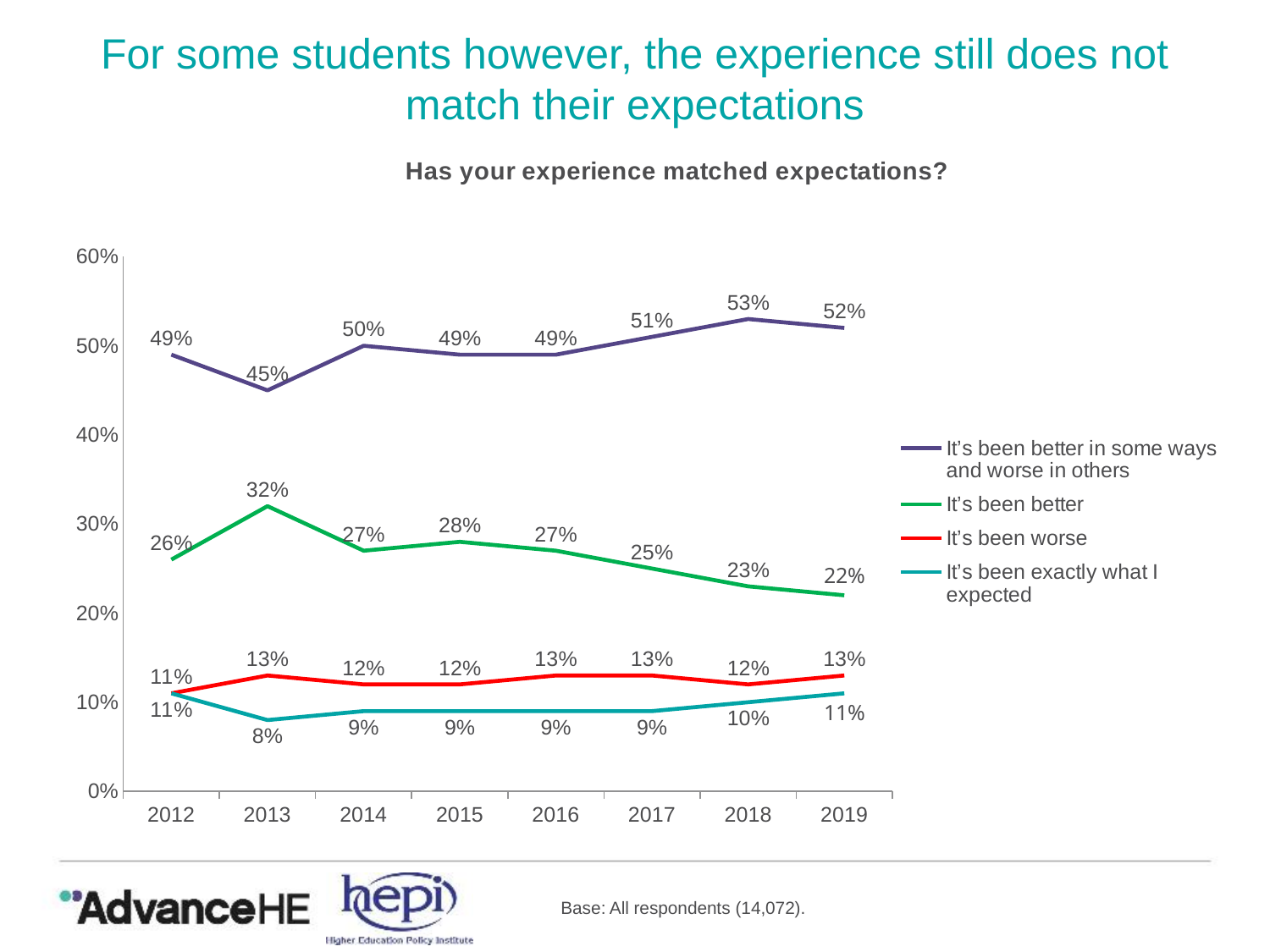
How many series does the legend list? 4 Does the value for "It's been better" rise or fall from 2015 to 2019? Fall What is the value for "It's been better in some ways and worse in others" in 2018? 53% In which year is "It's been better in some ways and worse in others" at its lowest? 2013 In which year is "It's been better" at its highest? 2013 What is the value for "It's been worse" in 2019? 13% What kind of chart is shown? Line chart What is the value for "It's been better" in 2013? 32% What is the value for "It's been exactly what I expected" in 2013? 8% How many years are shown on the x axis? 8 What is the difference between the 2013 and 2019 values for "It's been better"? 10% Which is larger in 2019: "It's been worse" or "It's been exactly what I expected"? It's been worse